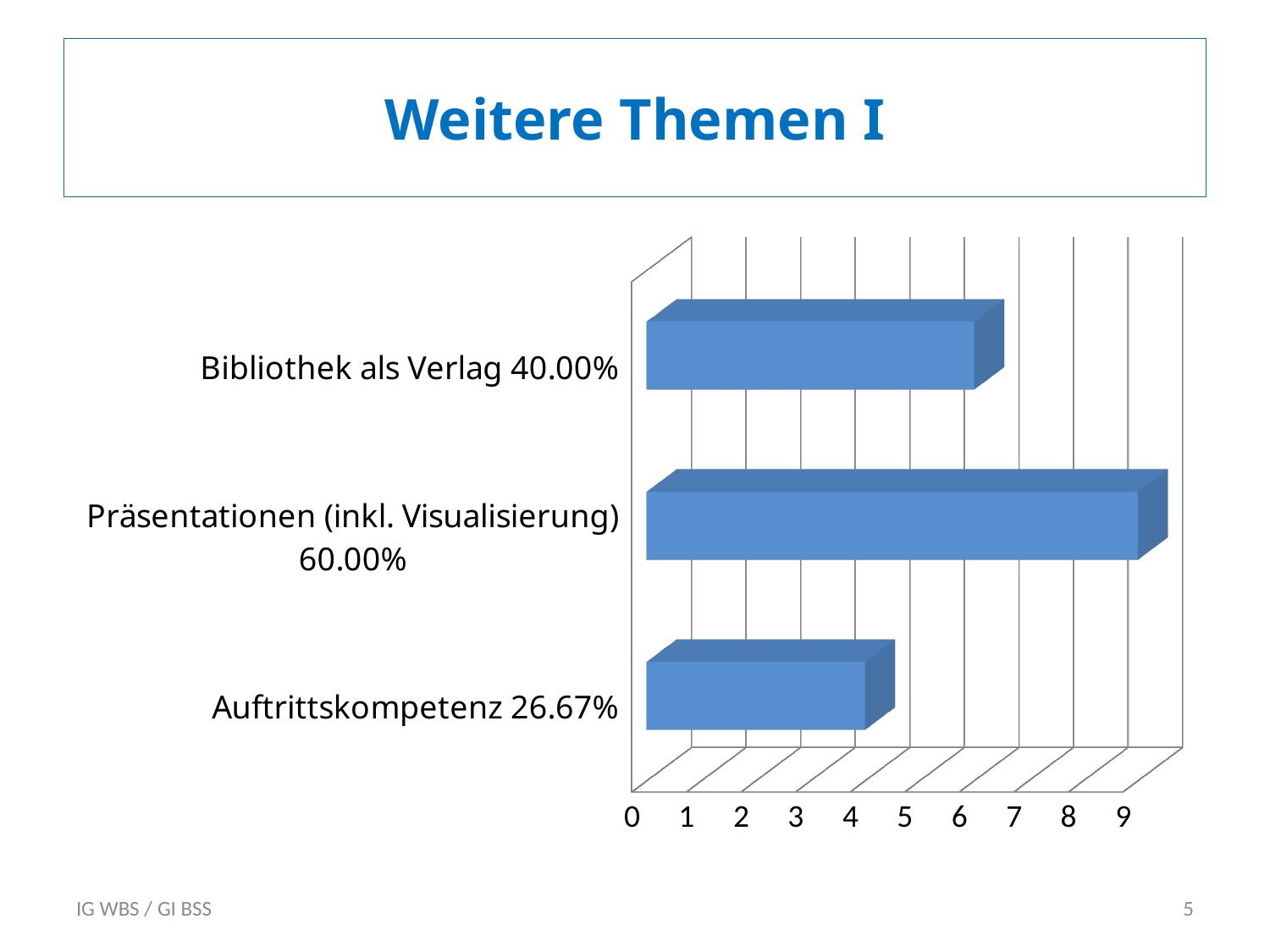
Is the value for Auftrittskompetenz greater or less than 5? less What percentage is printed in the category label for Auftrittskompetenz? 26.67% What is the title of the slide containing the chart? Weitere Themen I Is the value for Präsentationen (inkl. Visualisierung) greater or less than 8? greater Which category has the shortest bar? Auftrittskompetenz Which category has the longest bar? Präsentationen (inkl. Visualisierung) What kind of chart is shown on the slide? bar chart What percentage is printed in the category label for Bibliothek als Verlag? 40.00% Is the value for Bibliothek als Verlag greater or less than 5? greater How many categories does the chart show? 3 What percentage is printed in the category label for Präsentationen (inkl. Visualisierung)? 60.00% Which bar is longer: Bibliothek als Verlag or Auftrittskompetenz? Bibliothek als Verlag